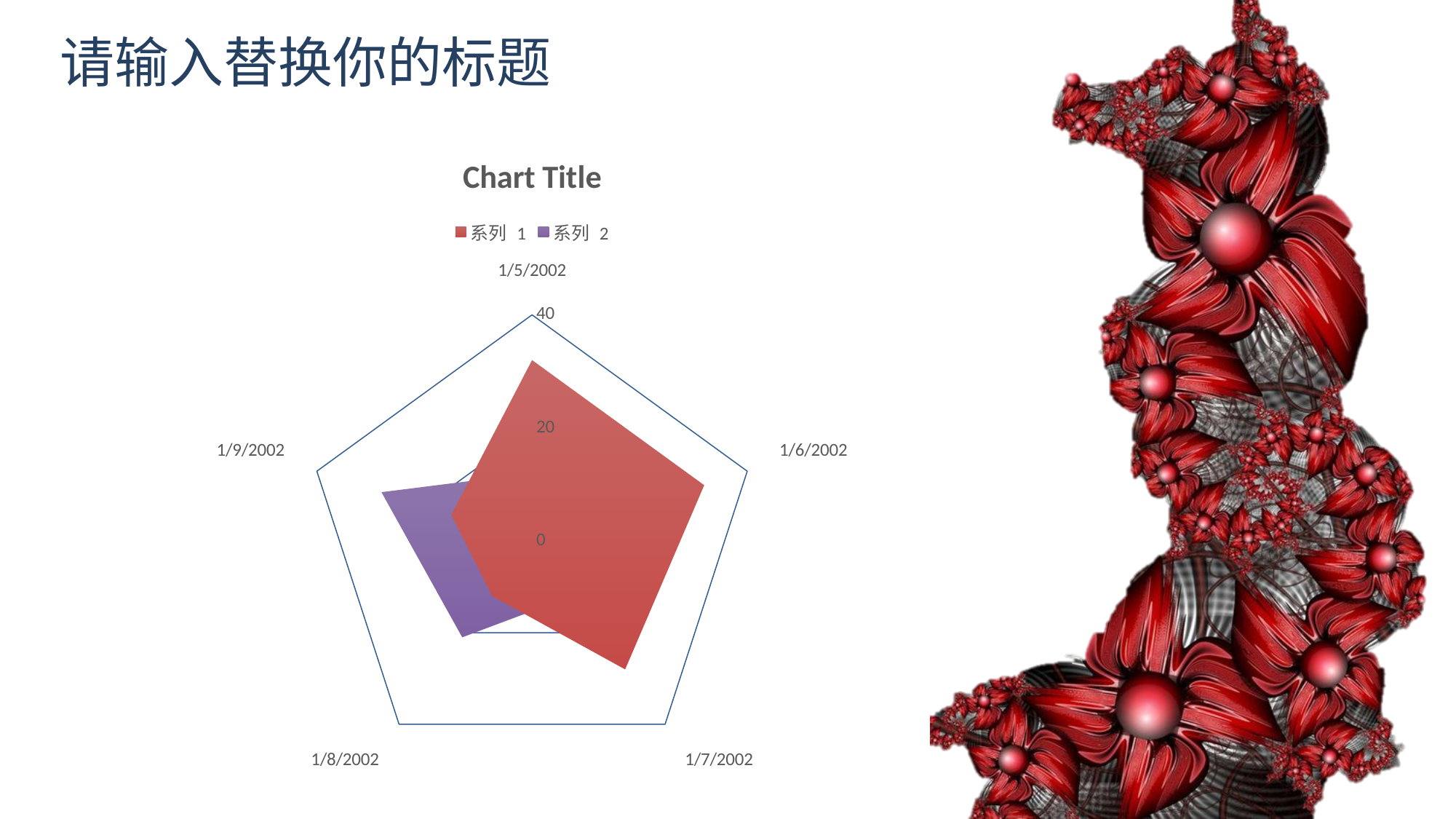
Is the value of 系列 2 for 1/9/2002 greater or less than 20? greater For 1/9/2002, which series has the larger value, 系列 1 or 系列 2? 系列 2 Is the value of 系列 1 for 1/5/2002 greater or less than 20? greater Is the value of 系列 1 for 1/7/2002 greater or less than 40? less What kind of chart is shown on the slide? radar chart What are the two series names shown in the legend? 系列 1, 系列 2 How many categories (axes) does the radar chart have? 5 How many series does the legend list? 2 For 1/6/2002, which series has the larger value, 系列 1 or 系列 2? 系列 1 What is the title of the chart? Chart Title